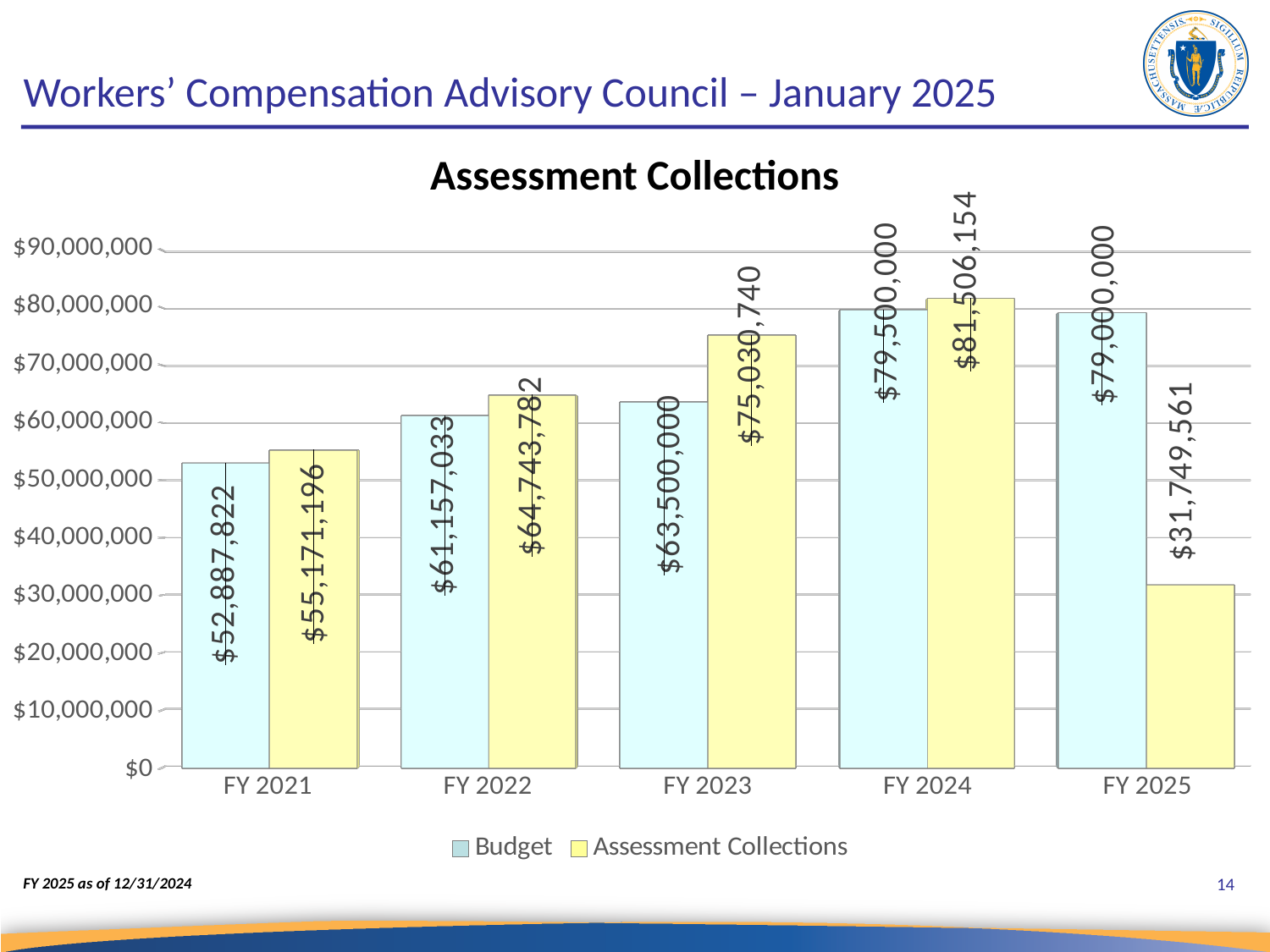
How many fiscal years are shown on the x axis? 5 What is the difference between Budget and Assessment Collections for FY 2025? $47,250,439 What is the Budget value for FY 2023? $63,500,000 What is the difference between Assessment Collections and Budget for FY 2023? $11,530,740 What type of chart is shown on the slide? Bar chart For FY 2024, which is larger: Budget or Assessment Collections? Assessment Collections Which fiscal year has the lowest Assessment Collections value? FY 2025 What is the Assessment Collections value for FY 2022? $64,743,782 How many series does the legend list? 2 What is the Budget value for FY 2021? $52,887,822 What is the Assessment Collections value for FY 2025? $31,749,561 Which fiscal year has the highest Assessment Collections value? FY 2024